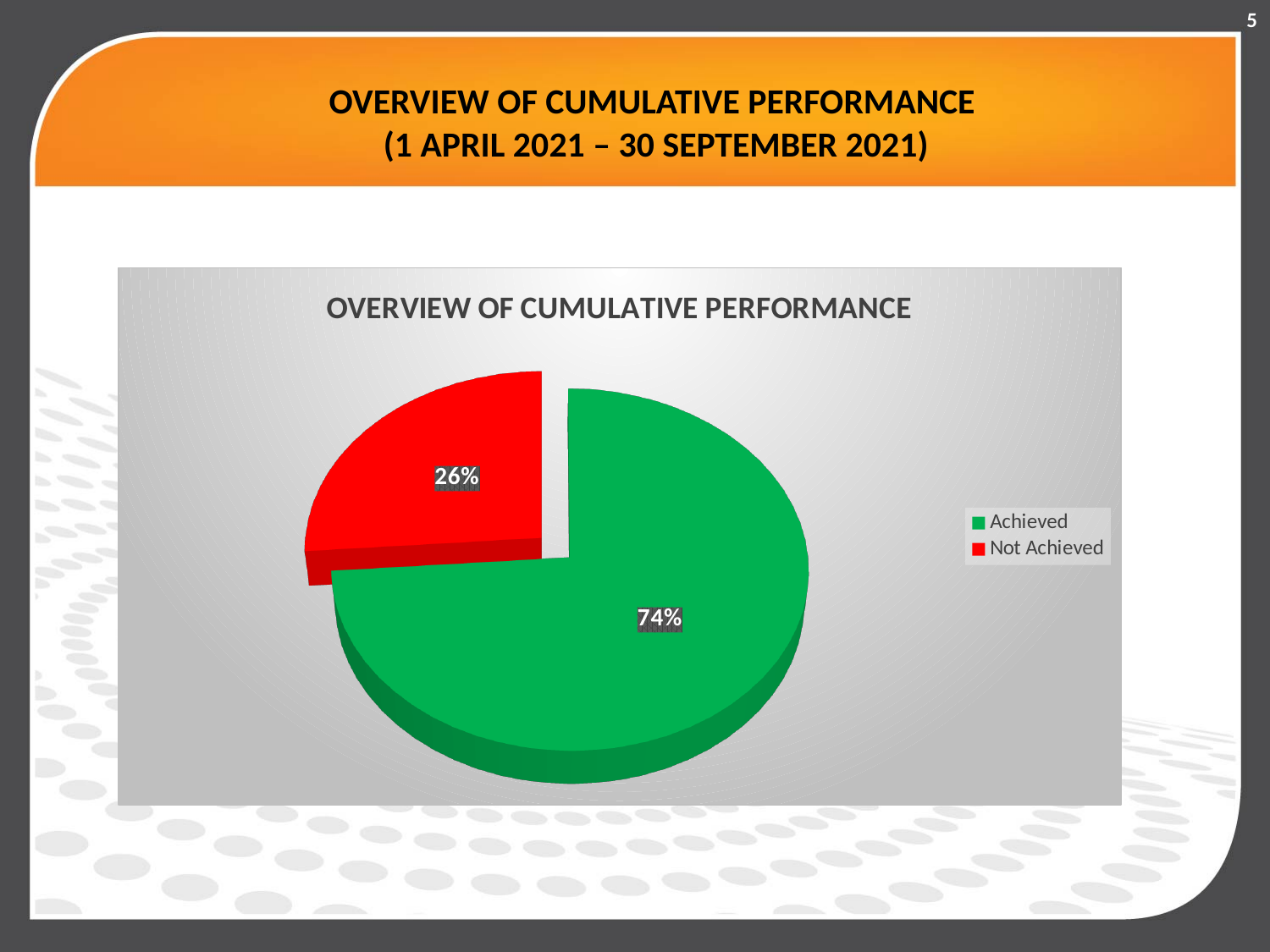
What percentage of the pie is labelled Achieved? 74% How many entries does the legend list? 2 Which slice of the pie is the smallest? Not Achieved What is the difference in percentage points between the Achieved and Not Achieved slices? 48 What percentage of the pie is labelled Not Achieved? 26% Which is larger, the Achieved slice or the Not Achieved slice? Achieved What kind of chart is shown on the slide? Pie chart What colour is the Not Achieved slice? Red What is the title of the chart? OVERVIEW OF CUMULATIVE PERFORMANCE How many slices does the pie chart have? 2 Which slice of the pie is the largest? Achieved What share of the pie does the Achieved slice represent? 74%